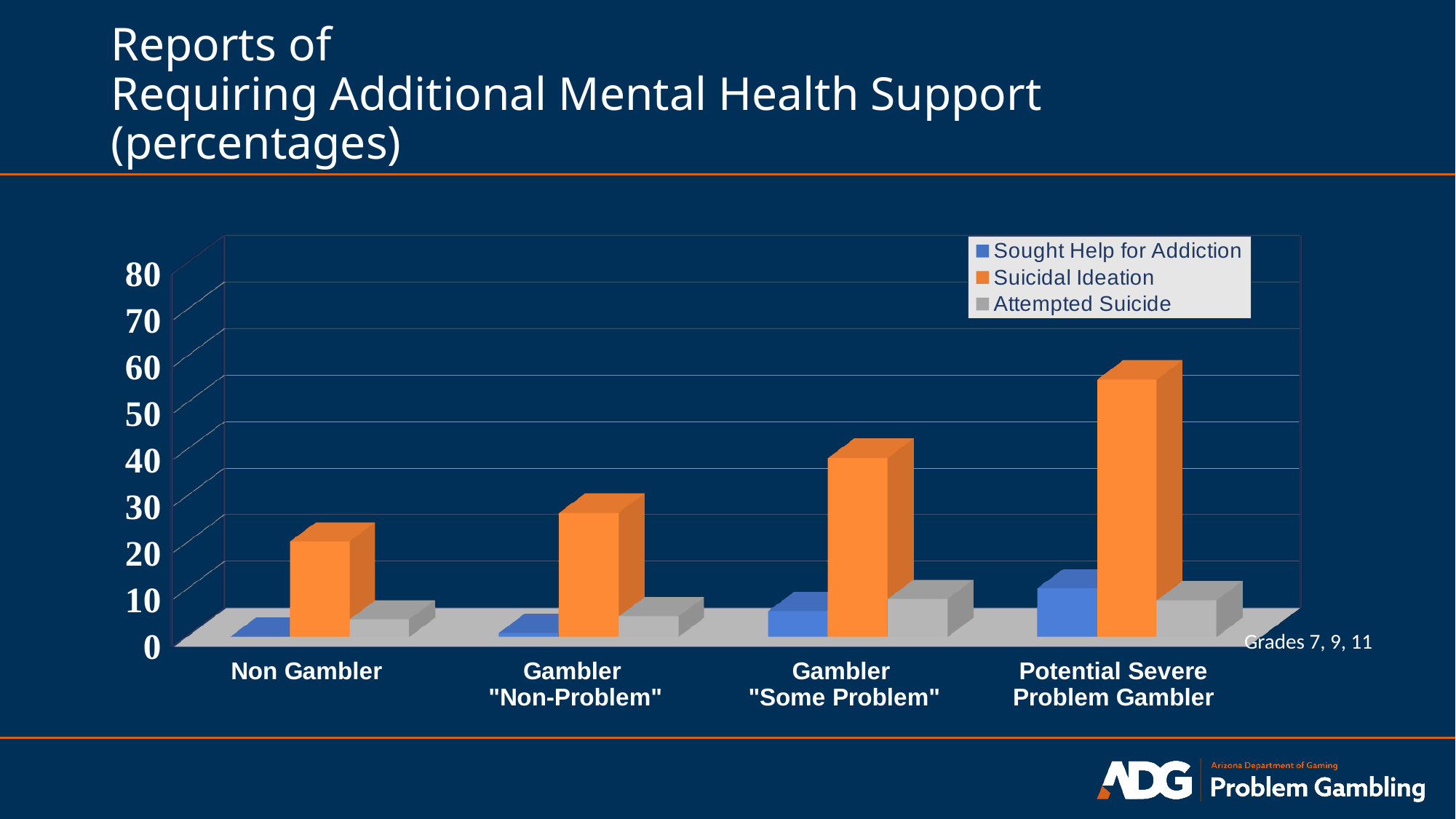
How many series does the legend list? 3 For Non Gambler, which is larger: Suicidal Ideation or Attempted Suicide? Suicidal Ideation Which category has the highest value for Suicidal Ideation? Potential Severe Problem Gambler How many categories are shown along the x axis? 4 Do the Suicidal Ideation values rise or fall moving from Non Gambler to Potential Severe Problem Gambler? rise Is the Suicidal Ideation value for Potential Severe Problem Gambler greater or less than 50? greater Which category has the lowest value for Suicidal Ideation? Non Gambler Which category has the highest value for Sought Help for Addiction? Potential Severe Problem Gambler Is the Suicidal Ideation value for Non Gambler greater or less than 30? less What kind of chart is shown on the slide? bar chart Which colour represents Suicidal Ideation in the legend? orange Is the Suicidal Ideation value for Gambler "Some Problem" greater or less than 50? less